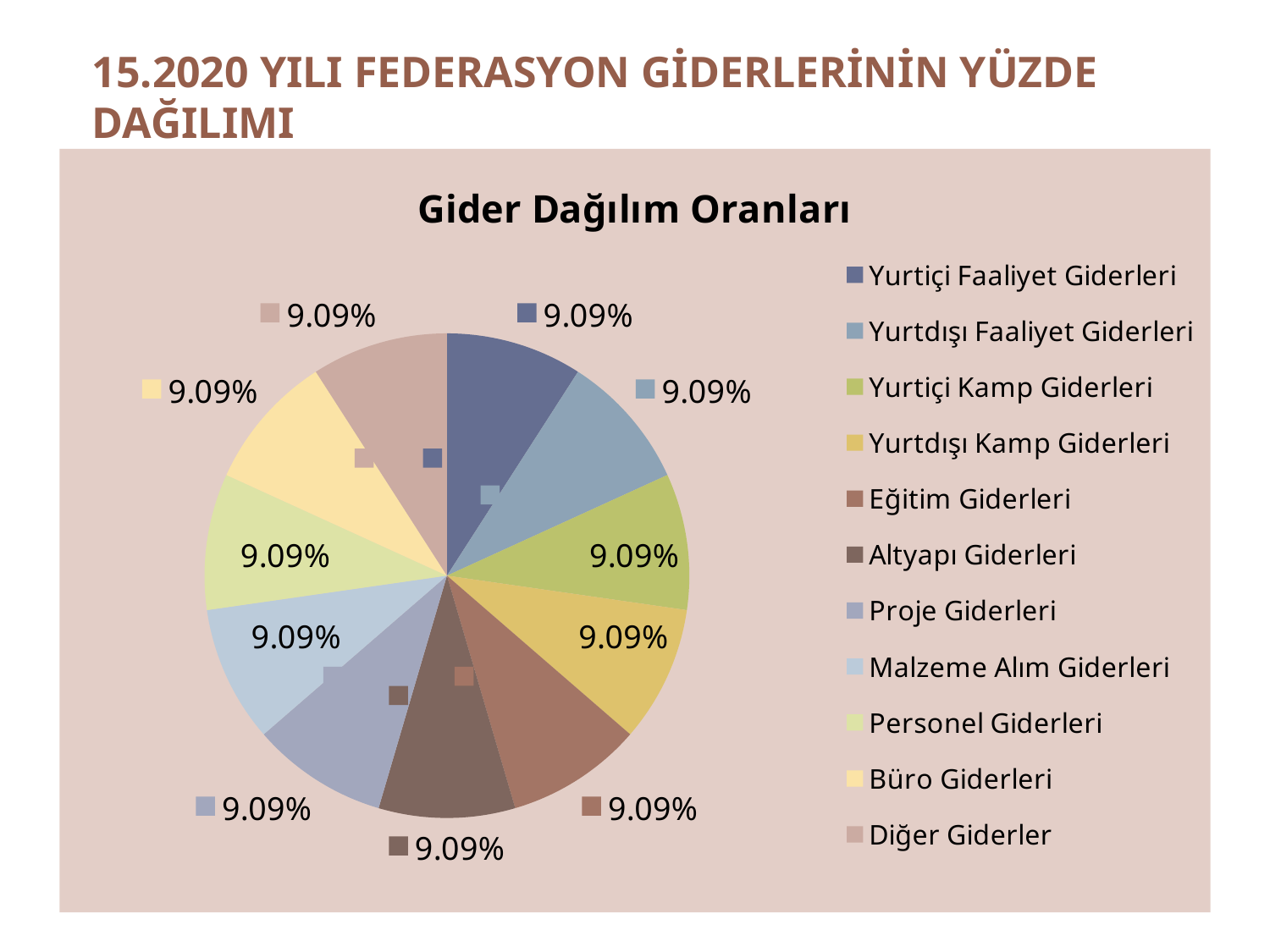
What is the value shown for Eğitim Giderleri? 9.09% Is the value for Altyapı Giderleri greater or less than 10%? less What is the value shown for Malzeme Alım Giderleri? 9.09% How many slices does the pie chart have? 11 How many entries does the legend list? 11 What is the value shown for Diğer Giderler? 9.09% Which legend entry is listed last? Diğer Giderler What share of the pie is Yurtiçi Faaliyet Giderleri? 9.09% What is the title of the chart? Gider Dağılım Oranları What is the difference between the values for Proje Giderleri and Büro Giderleri? 0% What kind of chart is shown on the slide? pie chart What share of the pie is Personel Giderleri? 9.09%